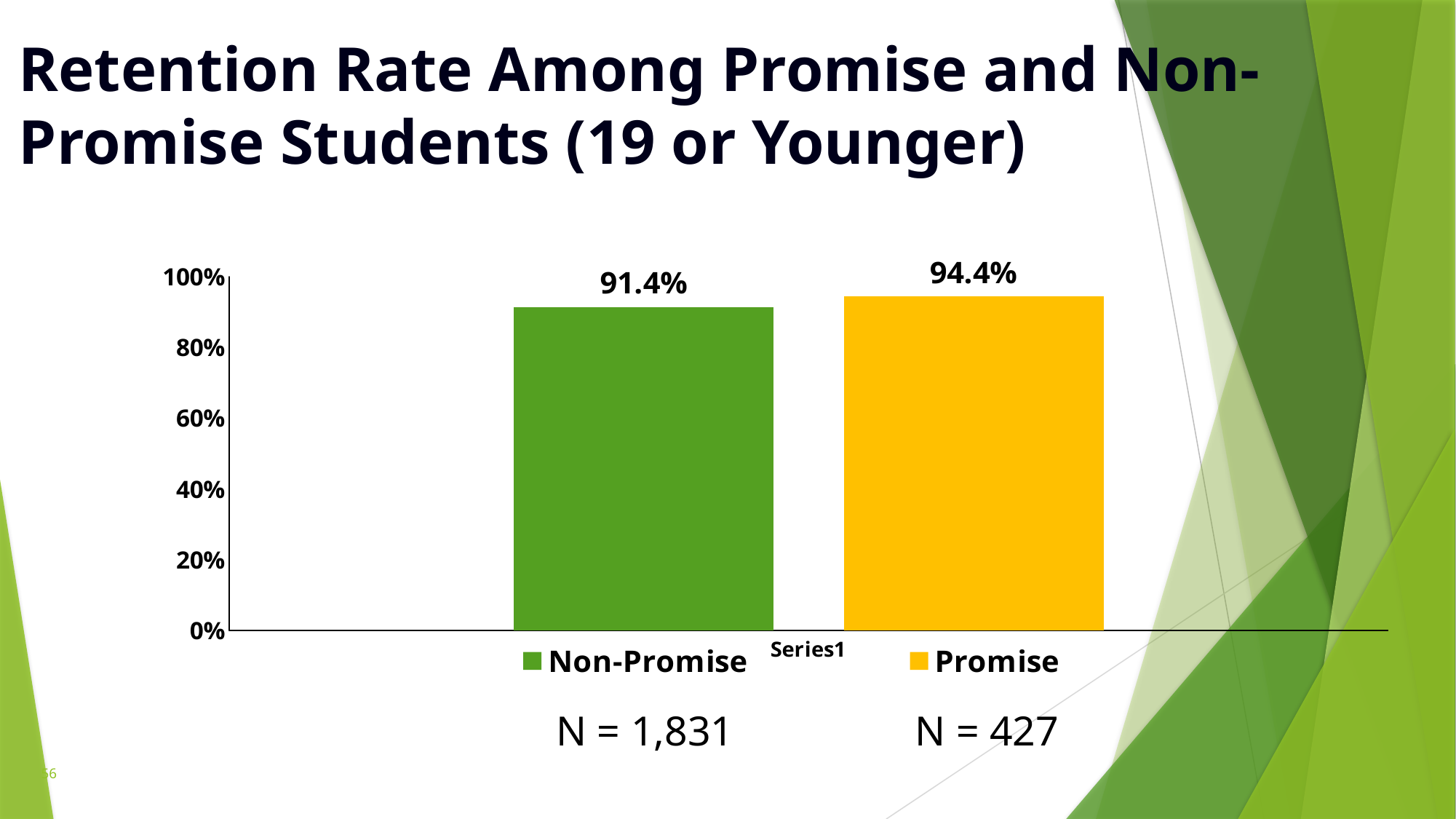
Which group has the lower retention rate? Non-Promise What is the difference in retention rate between Promise and Non-Promise students? 3.0% What is the retention rate for Non-Promise students? 91.4% What kind of chart is shown on the slide? Bar chart What colour is the bar for Promise students? Yellow What is the retention rate for Promise students? 94.4% Is the retention rate for Promise students greater or less than 100%? less What is the sample size (N) for the Non-Promise group? 1,831 How many bars are plotted in the chart? 2 Which group has the higher retention rate, Promise or Non-Promise? Promise How many series does the legend list? 2 Is the retention rate for Non-Promise students greater or less than 80%? greater